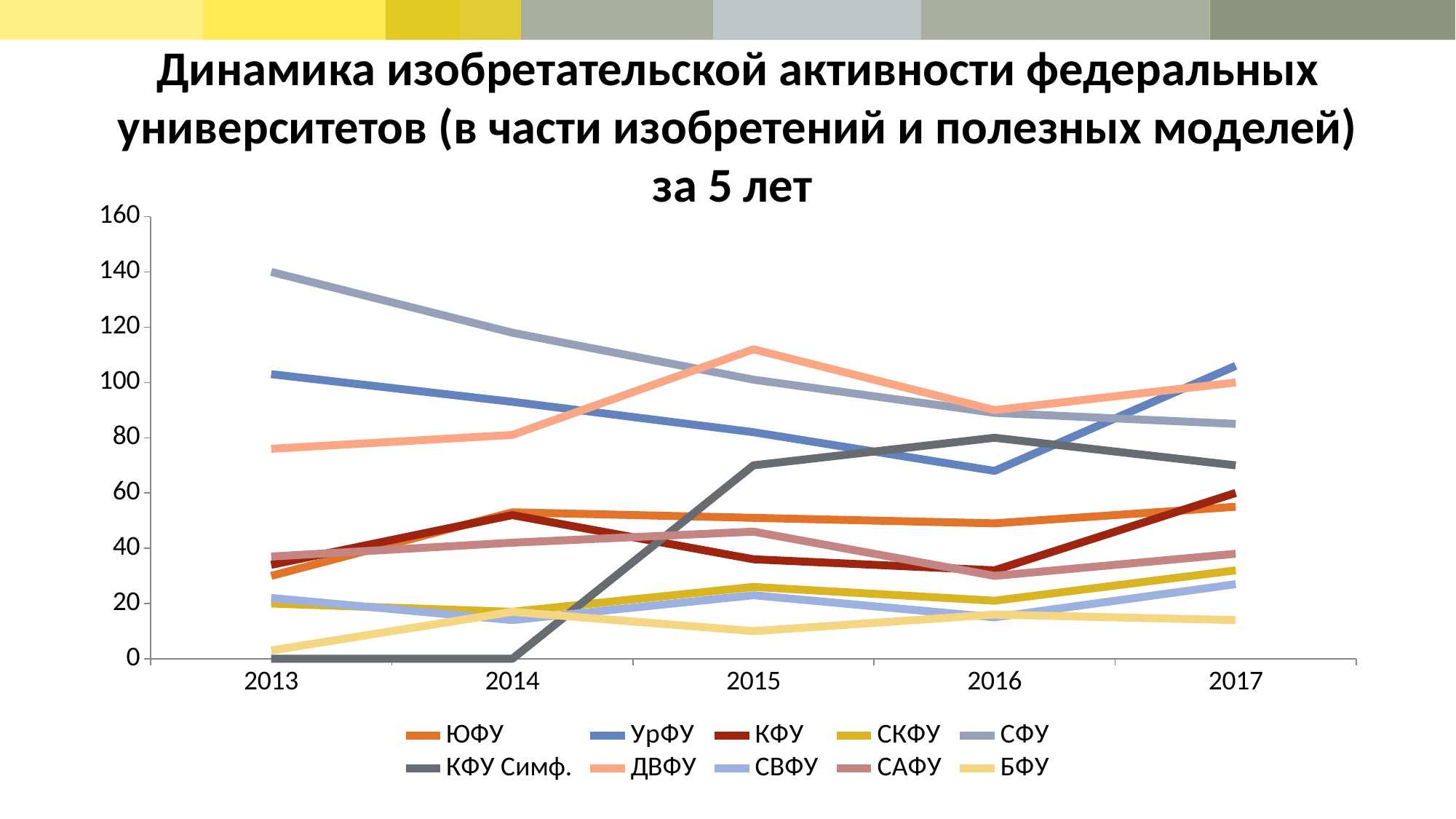
What is the first year shown on the x axis? 2013 Is the value for КФУ Симф. in 2014 greater or less than 20? less Which university has the lowest value in 2013? КФУ Симф. Which university has the highest value in 2015? ДВФУ Does the value for СФУ rise or fall from 2013 to 2017? fall What kind of chart is shown on the slide? line chart Is the value for ДВФУ in 2015 greater or less than 100? greater Is the value for СФУ in 2013 greater or less than 120? greater How many years are shown along the x axis? 5 Which university has the highest value in 2013? СФУ How many series does the legend list? 10 In 2017, which is larger: the value for УрФУ or the value for СФУ? УрФУ